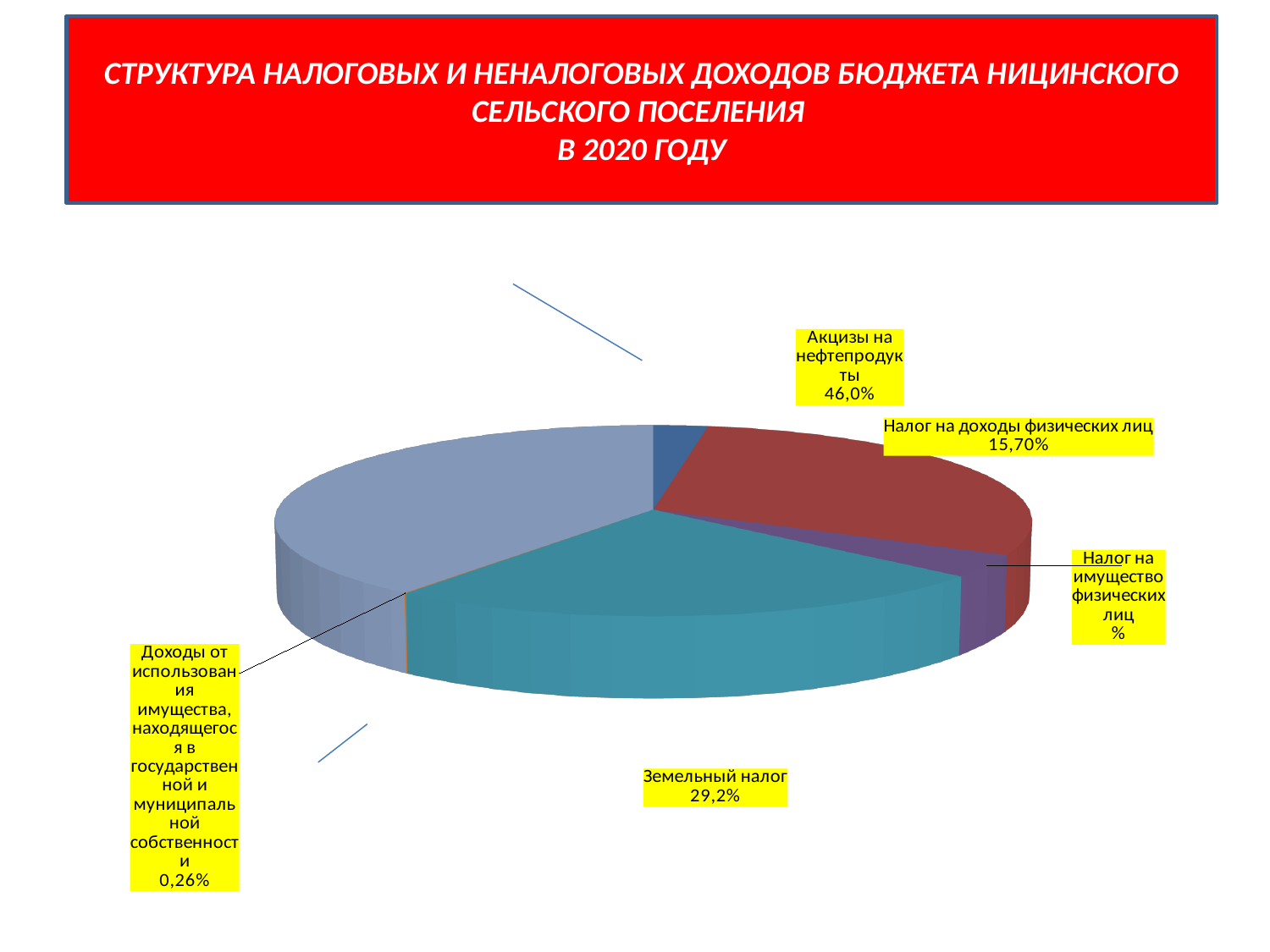
Which category has the largest labelled share? Акцизы на нефтепродукты Which category has the smallest labelled share? Доходы от использования имущества, находящегося в государственной и муниципальной собственности What is the difference in percentage points between the labelled shares of Акцизы на нефтепродукты and Земельный налог? 16,8 Which category's label shows only a % sign without a number? Налог на имущество физических лиц What kind of chart is shown on the slide? Pie chart How many categories are labelled on the pie chart? 5 Which has the larger labelled share, Земельный налог or Налог на доходы физических лиц? Земельный налог What share is labelled for Доходы от использования имущества, находящегося в государственной и муниципальной собственности? 0,26% What share is labelled for Налог на доходы физических лиц? 15,70% What share is labelled for Земельный налог? 29,2% For which year does the slide title say the revenue structure is shown? 2020 What share of the budget revenue is labelled for Акцизы на нефтепродукты? 46,0%